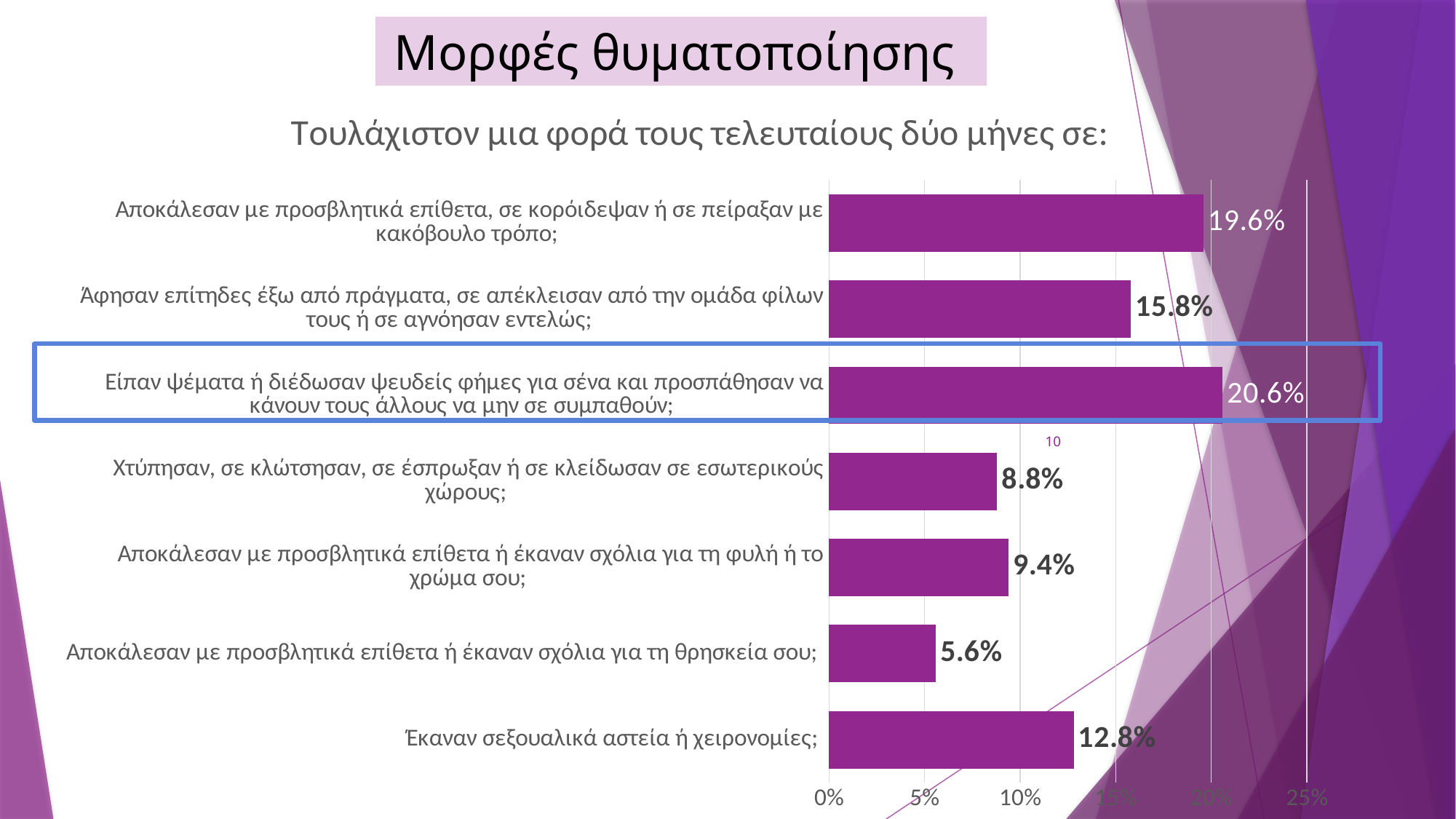
Is the value for "Έκαναν σεξουαλικά αστεία ή χειρονομίες;" greater or less than 10%? greater Which category has the highest value? Είπαν ψέματα ή διέδωσαν ψευδείς φήμες για σένα και προσπάθησαν να κάνουν τους άλλους να μην σε συμπαθούν; What is the value for "Είπαν ψέματα ή διέδωσαν ψευδείς φήμες για σένα και προσπάθησαν να κάνουν τους άλλους να μην σε συμπαθούν;"? 20.6% What is the difference between the value for "Αποκάλεσαν με προσβλητικά επίθετα, σε κορόιδεψαν ή σε πείραξαν με κακόβουλο τρόπο;" and the value for "Άφησαν επίτηδες έξω από πράγματα, σε απέκλεισαν από την ομάδα φίλων τους ή σε αγνόησαν εντελώς;"? 3.8% How many categories does the chart show? 7 What is the value for "Χτύπησαν, σε κλώτσησαν, σε έσπρωξαν ή σε κλείδωσαν σε εσωτερικούς χώρους;"? 8.8% Which is larger: the value for "Αποκάλεσαν με προσβλητικά επίθετα ή έκαναν σχόλια για τη φυλή ή το χρώμα σου;" or the value for "Χτύπησαν, σε κλώτσησαν, σε έσπρωξαν ή σε κλείδωσαν σε εσωτερικούς χώρους;"? Αποκάλεσαν με προσβλητικά επίθετα ή έκαναν σχόλια για τη φυλή ή το χρώμα σου; What is the value for "Έκαναν σεξουαλικά αστεία ή χειρονομίες;"? 12.8% Which category has the lowest value? Αποκάλεσαν με προσβλητικά επίθετα ή έκαναν σχόλια για τη θρησκεία σου; What is the value for "Αποκάλεσαν με προσβλητικά επίθετα ή έκαναν σχόλια για τη θρησκεία σου;"? 5.6% What is the title of the slide containing the chart? Μορφές θυματοποίησης What type of chart is shown on the slide? bar chart